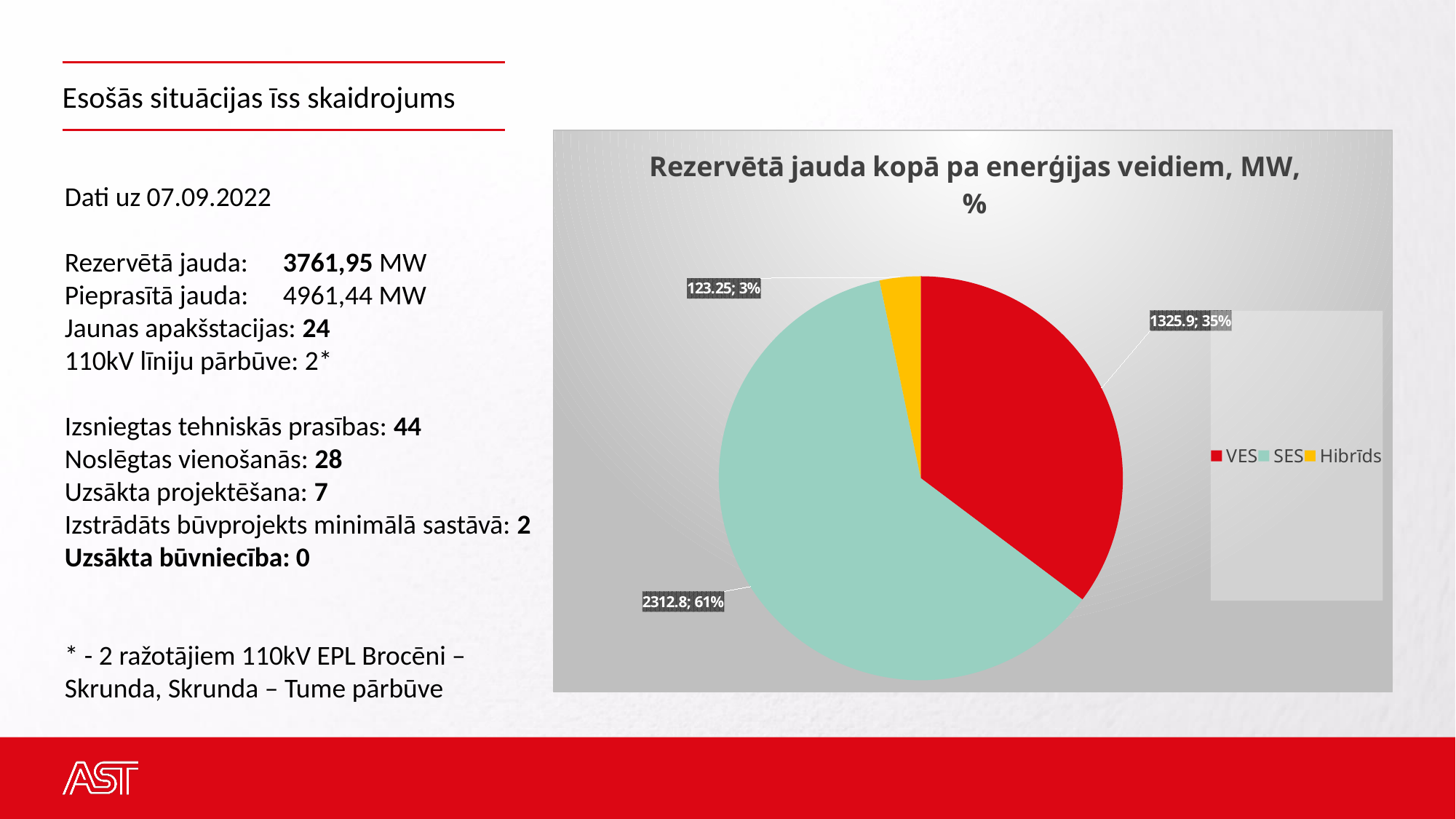
How many series does the legend list? 3 Which category has the smallest slice? Hibrīds What share of the pie does VES represent? 35% What is the value in MW for Hibrīds? 123.25 Which category has the largest slice? SES How many slices does the pie chart have? 3 What is the title of the chart? Rezervētā jauda kopā pa enerģijas veidiem, MW, % What is the value in MW for VES? 1325.9 What is the value in MW for SES? 2312.8 What is the difference in MW between SES and VES? 986.9 What share of the pie does SES represent? 61% What kind of chart is shown on the slide? pie chart